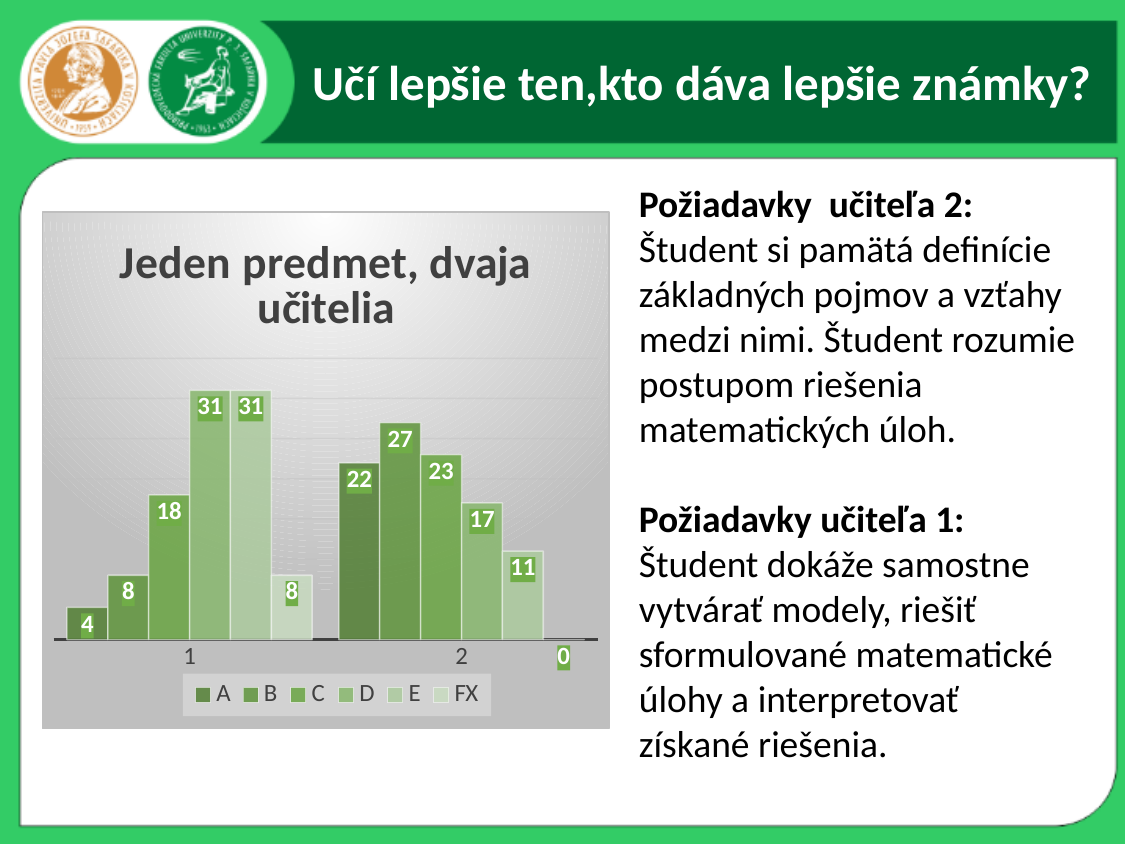
Which series has the highest value in category 2? B What is the title of the chart? Jeden predmet, dvaja učitelia What is the value for series C in category 1? 18 Which is larger: series A in category 1 or series A in category 2? Series A in category 2 What is the difference between series D in category 1 and series D in category 2? 14 How many series does the legend list? 6 Which series has the lowest value in category 1? A What is the value for series B in category 2? 27 What kind of chart is shown on the slide? Bar chart How many categories are shown on the x axis? 2 What is the value for series A in category 1? 4 What is the value for series FX in category 2? 0